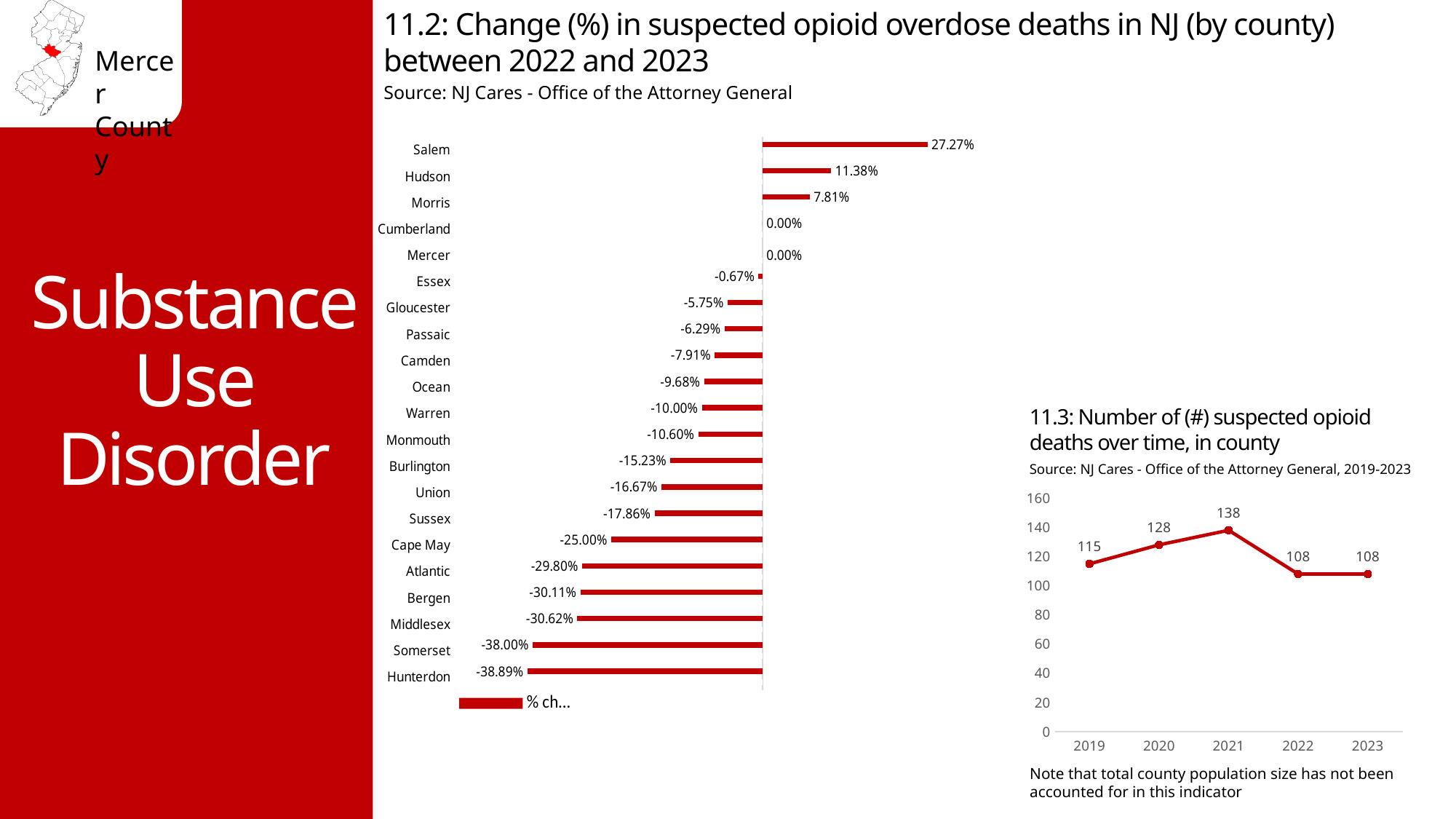
In the chart '11.3: Number of (#) suspected opioid deaths over time, in county', what is the value for 2021? 138 In the chart '11.3: Number of (#) suspected opioid deaths over time, in county', how many years are plotted? 5 In the chart '11.3: Number of (#) suspected opioid deaths over time, in county', what is the difference between the values for 2021 and 2022? 30 In the chart '11.2: Change (%) in suspected opioid overdose deaths in NJ (by county) between 2022 and 2023', how many counties are shown? 21 In the chart '11.3: Number of (#) suspected opioid deaths over time, in county', which year has the highest value? 2021 In the chart '11.2: Change (%) in suspected opioid overdose deaths in NJ (by county) between 2022 and 2023', which is larger, the value for Hudson or the value for Morris? Hudson What kind of chart is '11.3: Number of (#) suspected opioid deaths over time, in county'? Line chart What kind of chart is '11.2: Change (%) in suspected opioid overdose deaths in NJ (by county) between 2022 and 2023'? Bar chart In the chart '11.2: Change (%) in suspected opioid overdose deaths in NJ (by county) between 2022 and 2023', which county has the highest value? Salem In the chart '11.2: Change (%) in suspected opioid overdose deaths in NJ (by county) between 2022 and 2023', what is the value for Mercer? 0.00% In the chart '11.2: Change (%) in suspected opioid overdose deaths in NJ (by county) between 2022 and 2023', what is the value for Salem? 27.27% In the chart '11.2: Change (%) in suspected opioid overdose deaths in NJ (by county) between 2022 and 2023', which county has the lowest value? Hunterdon